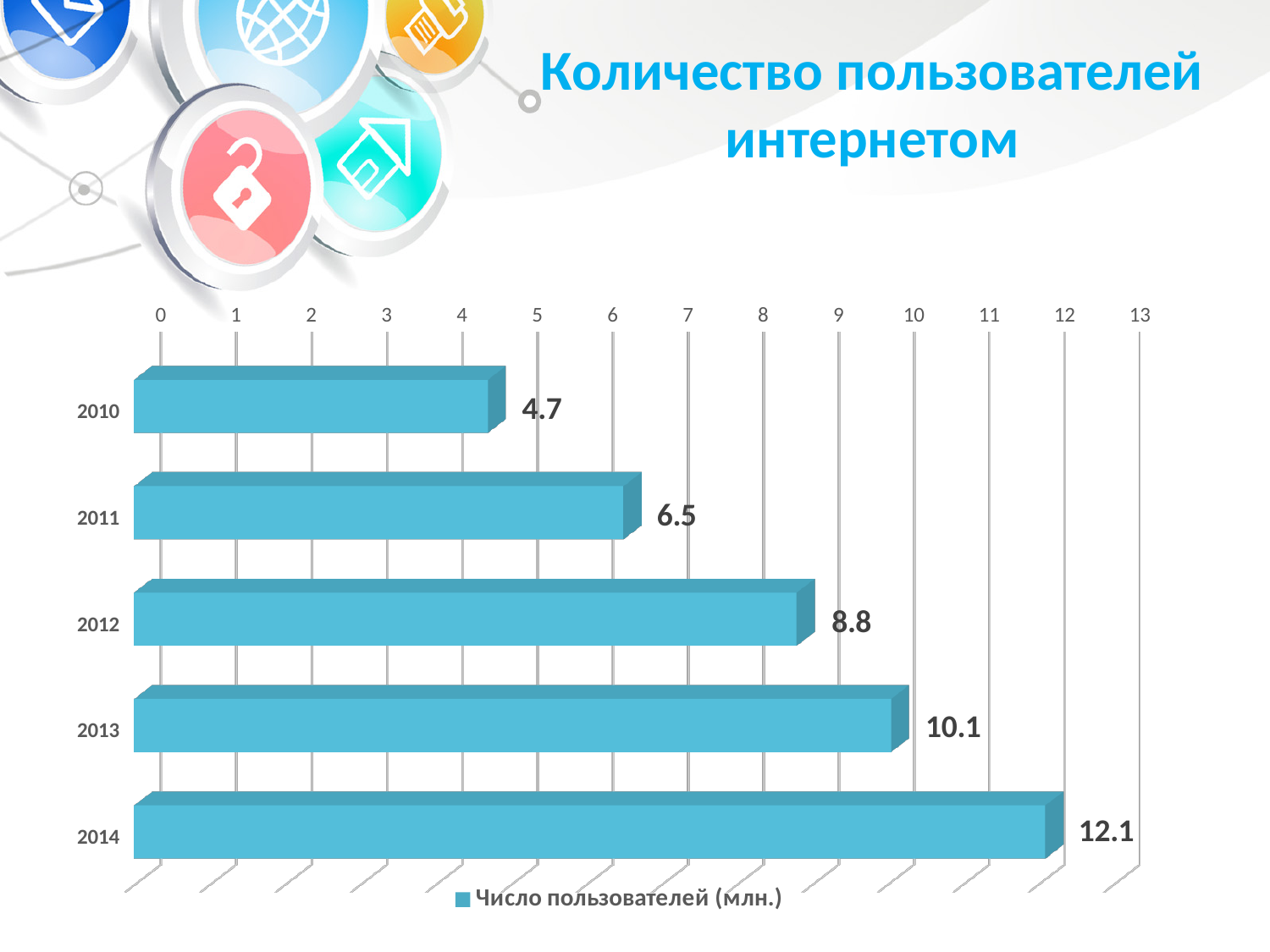
How many years are shown on the chart? 5 What kind of chart is shown on the slide? bar chart Which is larger, the value for 2011 or the value for 2012? 2012 Which year has the lowest value? 2010 What is the value for 2012? 8.8 Do the values rise or fall from 2010 to 2014? rise What is the difference between the values for 2011 and 2010? 1.8 Which year has the highest value? 2014 What is the value for 2014? 12.1 What is the value for 2010? 4.7 Is the value for 2013 greater or less than 9? greater What is the difference between the values for 2014 and 2013? 2.0